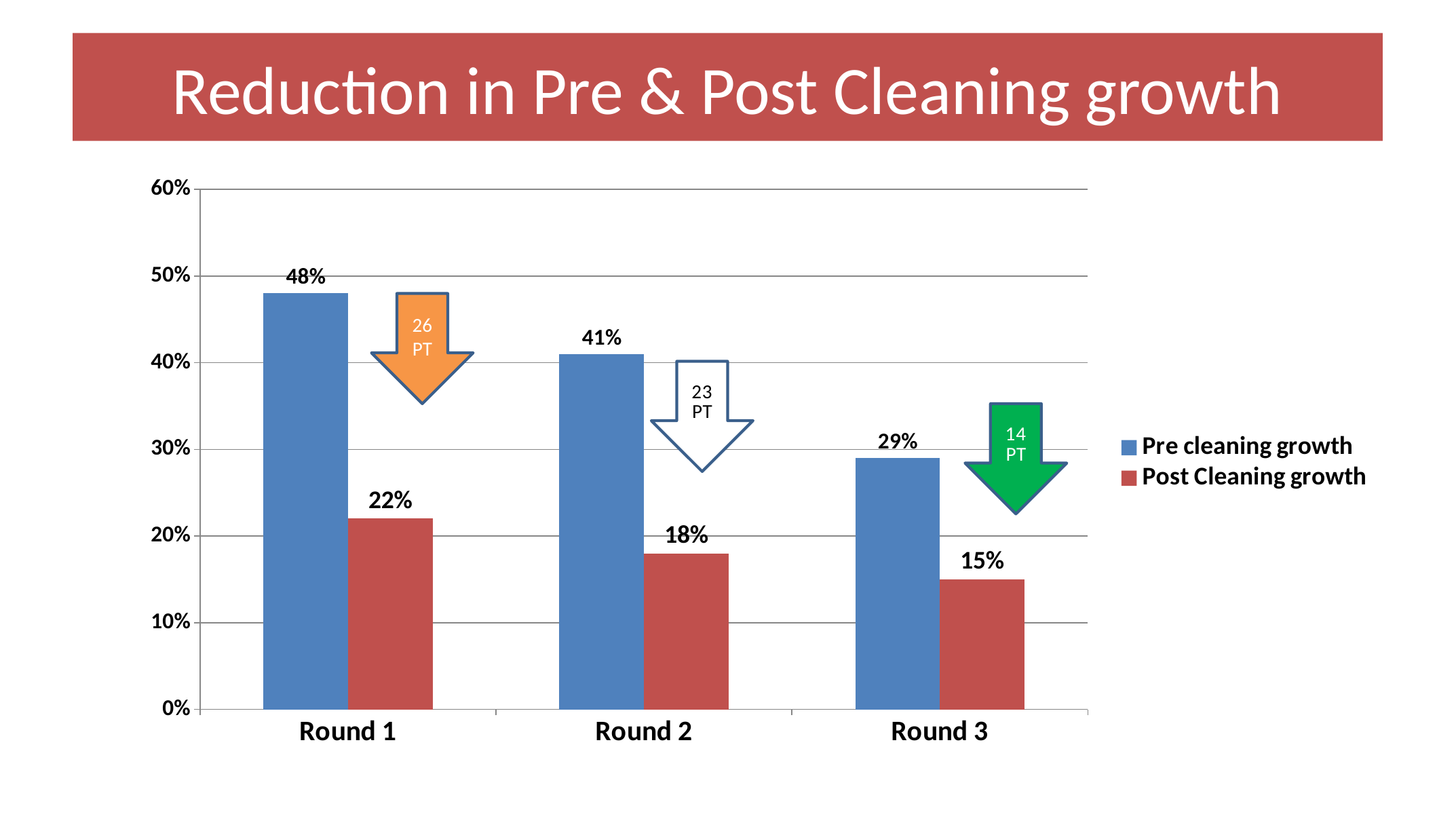
What kind of chart is shown on the slide? Bar chart Which round has the highest Pre cleaning growth? Round 1 How many rounds are shown on the x axis? 3 Does Pre cleaning growth rise or fall from Round 1 to Round 3? Fall What is the Post Cleaning growth value for Round 3? 15% What is the Post Cleaning growth value for Round 2? 18% What is the difference between Pre cleaning growth and Post Cleaning growth in Round 1? 26% Which round has the lowest Post Cleaning growth? Round 3 What is the difference between Pre cleaning growth in Round 2 and Round 3? 12% What is the Pre cleaning growth value for Round 1? 48% How many series does the legend list? 2 Which is larger: Post Cleaning growth in Round 1 or Pre cleaning growth in Round 3? Pre cleaning growth in Round 3